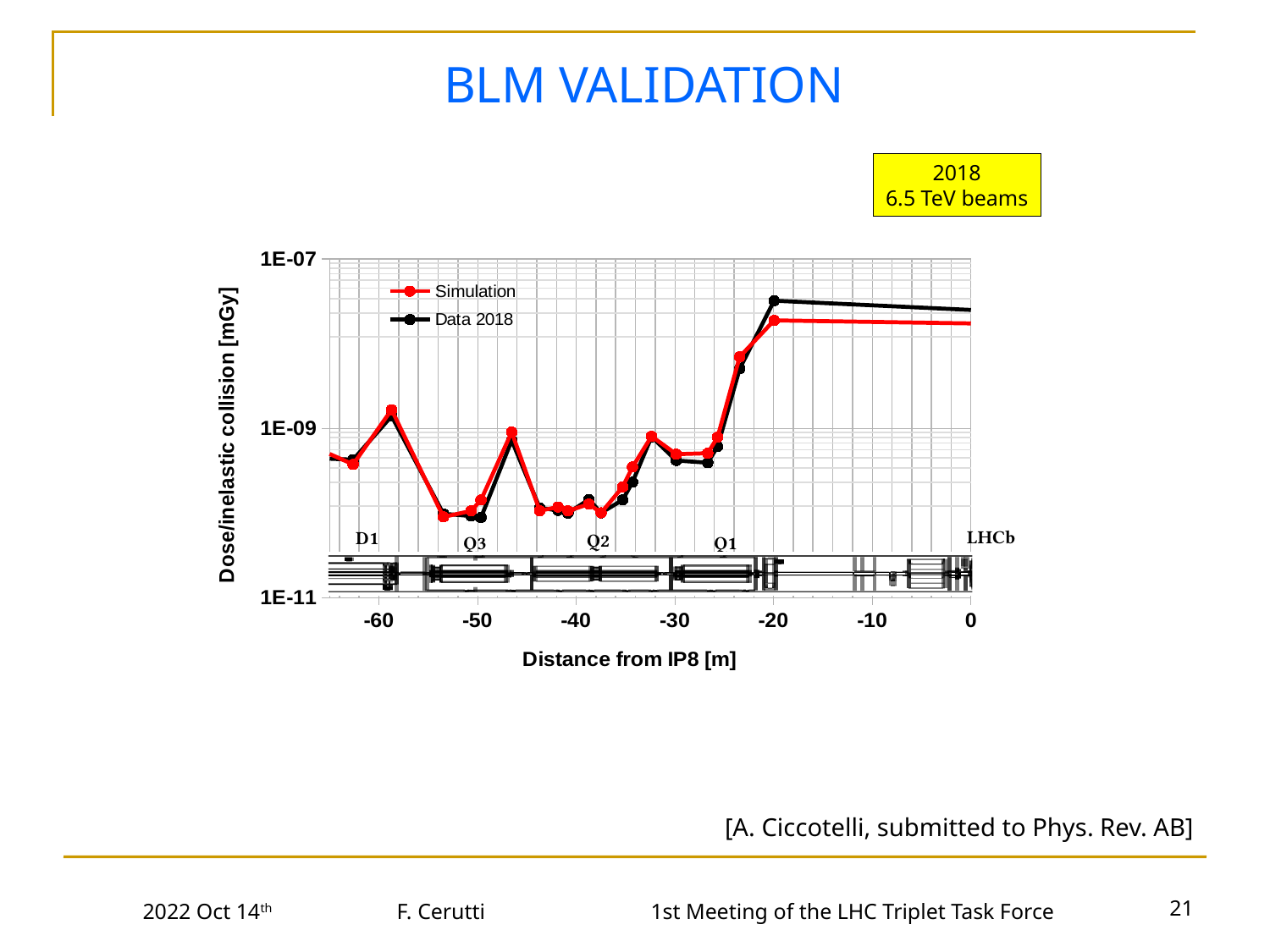
At a distance of -20 m, which series has the larger value, Simulation or Data 2018? Data 2018 Is the Simulation value at a distance of -50 m greater or less than 1E-09? less How many series does the legend list? 2 Which series reaches the highest value anywhere on the chart? Data 2018 What kind of chart is shown on the slide? line chart Is the Simulation value at a distance of 0 m greater or less than 1E-09? greater Between -30 m and -20 m, do the plotted values rise or fall? rise At a distance of 0 m, which series has the larger value, Simulation or Data 2018? Data 2018 Is the Data 2018 value at a distance of -40 m greater or less than 1E-09? less What are the two series named in the legend? Simulation and Data 2018 What is the title of the x axis? Distance from IP8 [m]